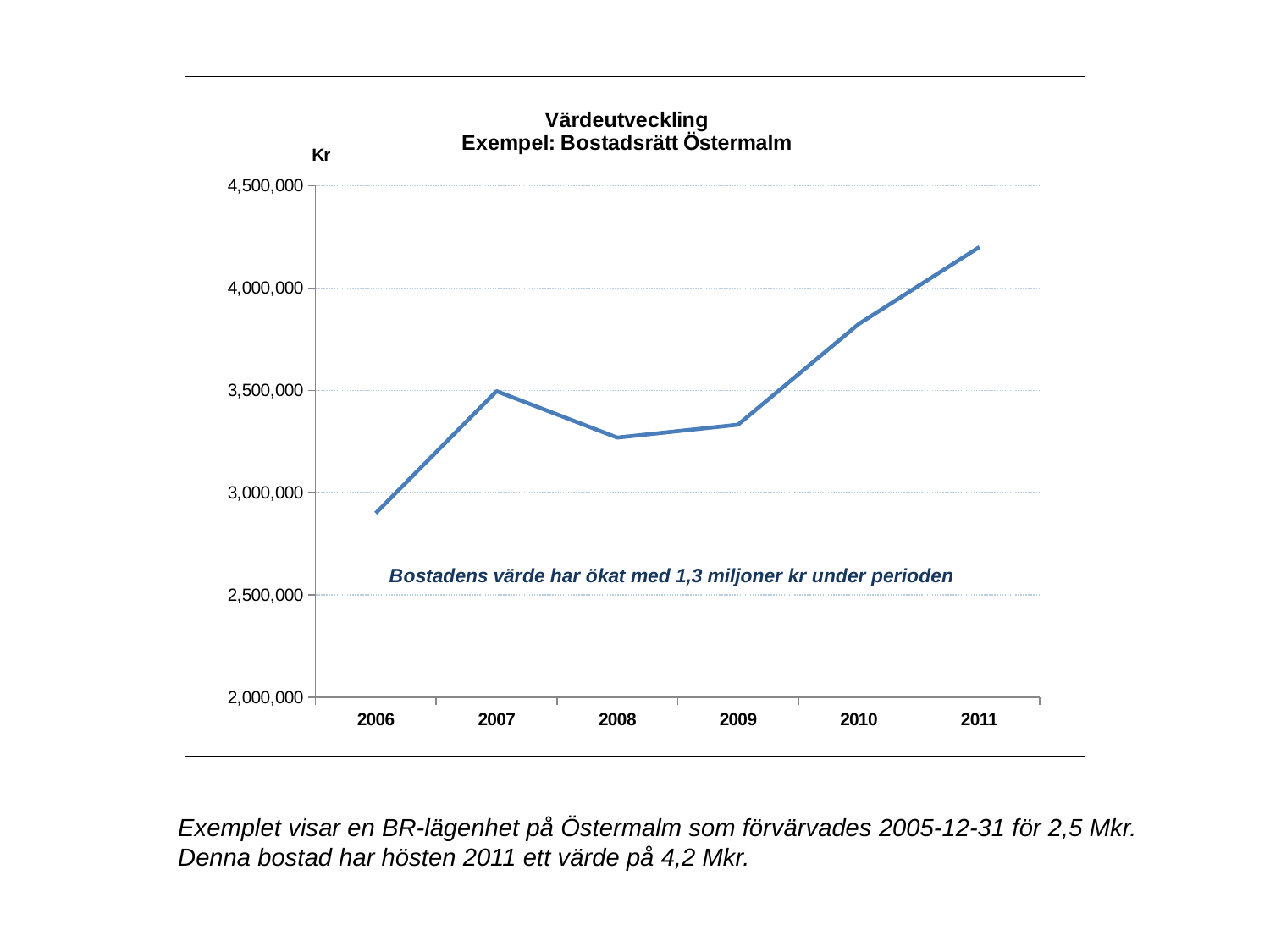
In which year is the plotted value lowest? 2006 Is the value for 2011 greater or less than 4,000,000? greater What unit label is shown at the top of the y axis? Kr What is the title of the chart? Värdeutveckling Exempel: Bostadsrätt Östermalm Is the value for 2010 greater or less than 4,000,000? less What kind of chart is shown on the slide? Line chart How many years are plotted along the x axis of the chart? 6 Which year has the larger value, 2007 or 2008? 2007 Is the value for 2006 greater or less than 3,000,000? less Does the value rise or fall between 2009 and 2011? Rise In which year is the plotted value highest? 2011